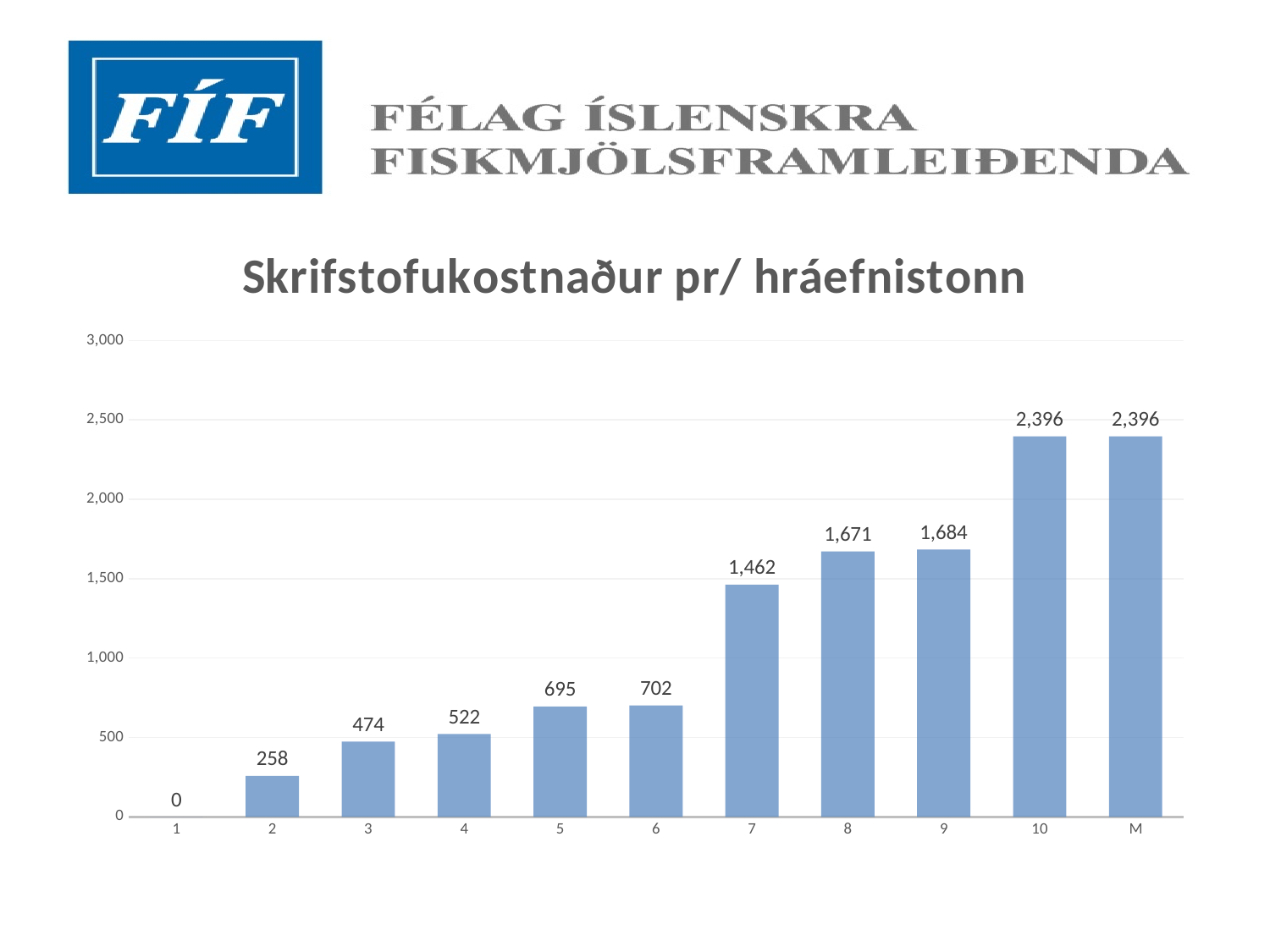
Which is larger, the value for category 5 or the value for category 6? 6 How many categories are shown on the x axis? 11 What is the title of the chart? Skrifstofukostnaður pr/ hráefnistonn What kind of chart is shown on the slide? bar chart What is the value for category M? 2,396 Which category has the lowest value? 1 What is the value for category 3? 474 What is the difference between the values for category 9 and category 8? 13 What is the value for category 7? 1,462 Is the value for category 8 greater or less than 1,500? greater What is the difference between the values for category 10 and category 7? 934 What is the highest value shown in the chart? 2,396